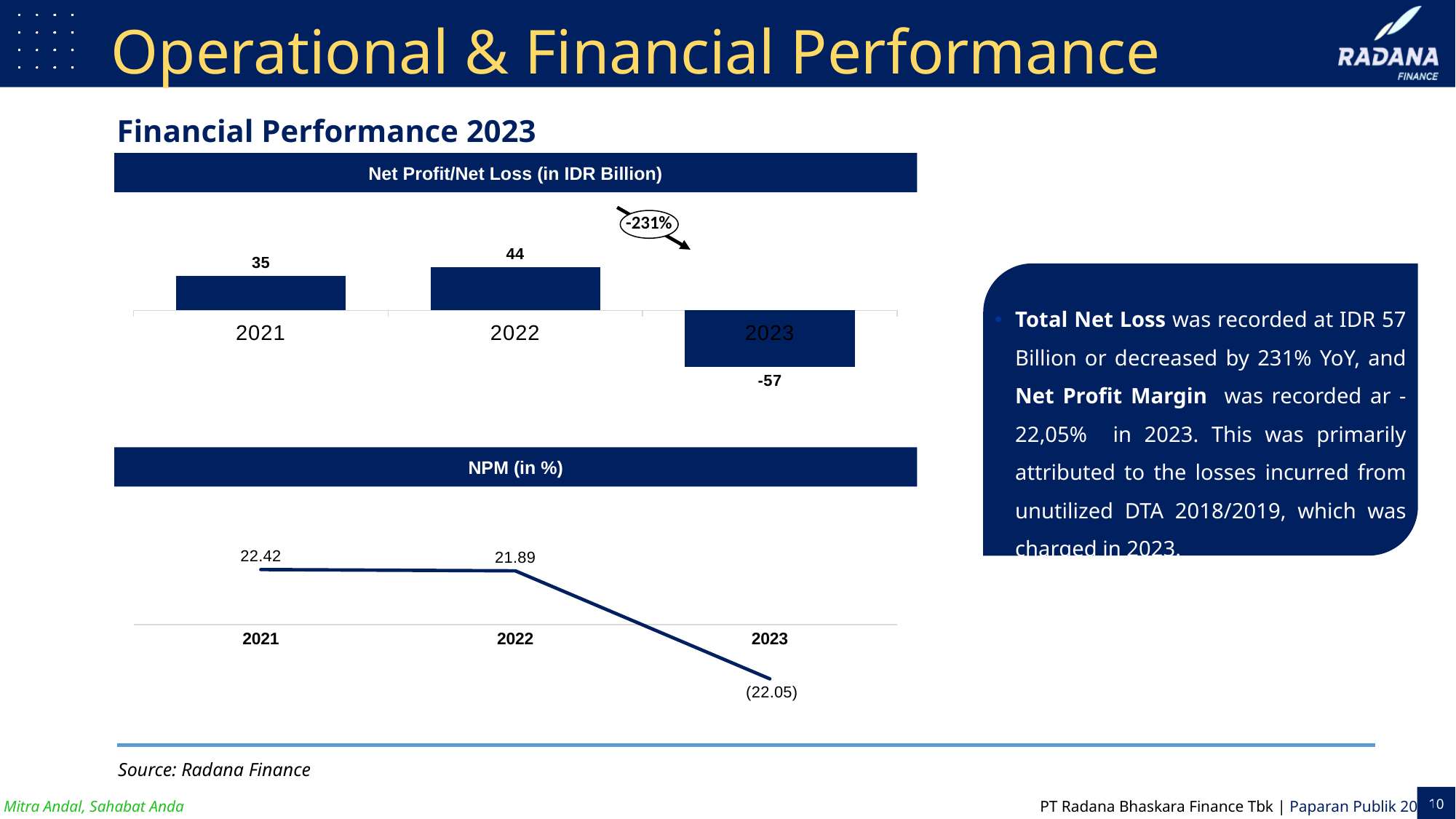
In the Net Profit/Net Loss (in IDR Billion) chart, what is the value for 2022? 44 How many years are shown in the Net Profit/Net Loss (in IDR Billion) chart? 3 In the Net Profit/Net Loss (in IDR Billion) chart, what is the value for 2023? -57 In the NPM (in %) chart, what is the value for 2023? (22.05) In the Net Profit/Net Loss (in IDR Billion) chart, which year has the highest value? 2022 In the NPM (in %) chart, what is the value for 2021? 22.42 In the Net Profit/Net Loss (in IDR Billion) chart, what is the difference between the 2022 and 2021 values? 9 What kind of chart is the Net Profit/Net Loss (in IDR Billion) chart? Bar chart What kind of chart is the NPM (in %) chart? Line chart In the NPM (in %) chart, do the values rise or fall from 2021 to 2023? Fall In the Net Profit/Net Loss (in IDR Billion) chart, which year has the lowest value? 2023 In the NPM (in %) chart, which is larger, the value for 2021 or the value for 2022? 2021